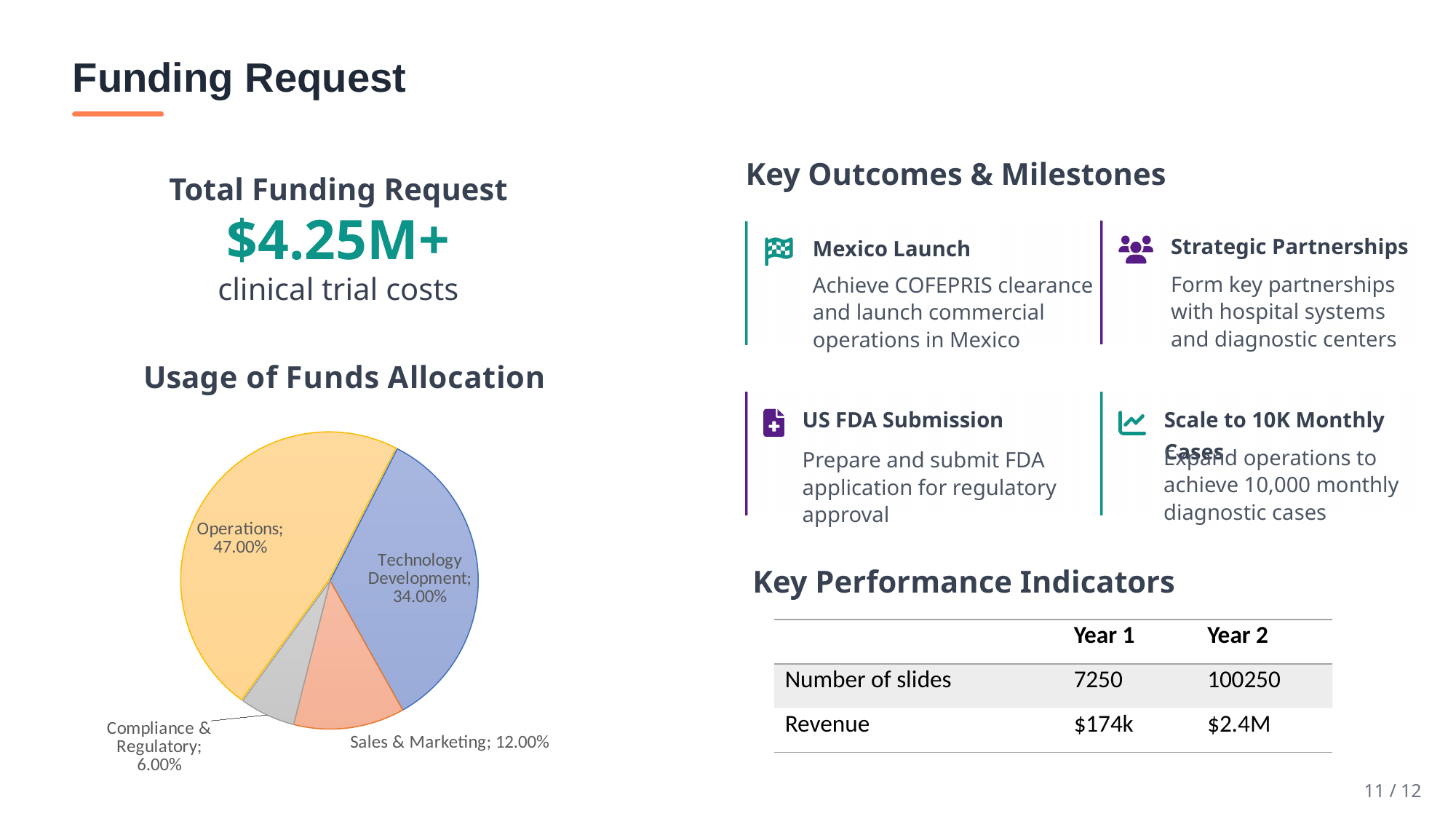
What type of chart is used to show the Usage of Funds Allocation? Pie chart What is the difference in percentage points between the Operations and Technology Development shares? 13.00% What share of funds is allocated to Sales & Marketing in the pie chart? 12.00% What share of funds is allocated to Operations in the Usage of Funds Allocation pie chart? 47.00% How many categories are shown in the Usage of Funds Allocation pie chart? 4 Which is larger in the pie chart: Sales & Marketing or Compliance & Regulatory? Sales & Marketing What colour is the Operations slice in the pie chart? Yellow Which category receives the smallest share of funds in the pie chart? Compliance & Regulatory What share of funds is allocated to Compliance & Regulatory in the pie chart? 6.00% What share of funds is allocated to Technology Development in the pie chart? 34.00% What is the title of the chart on the slide? Usage of Funds Allocation Which category receives the largest share of funds in the pie chart? Operations